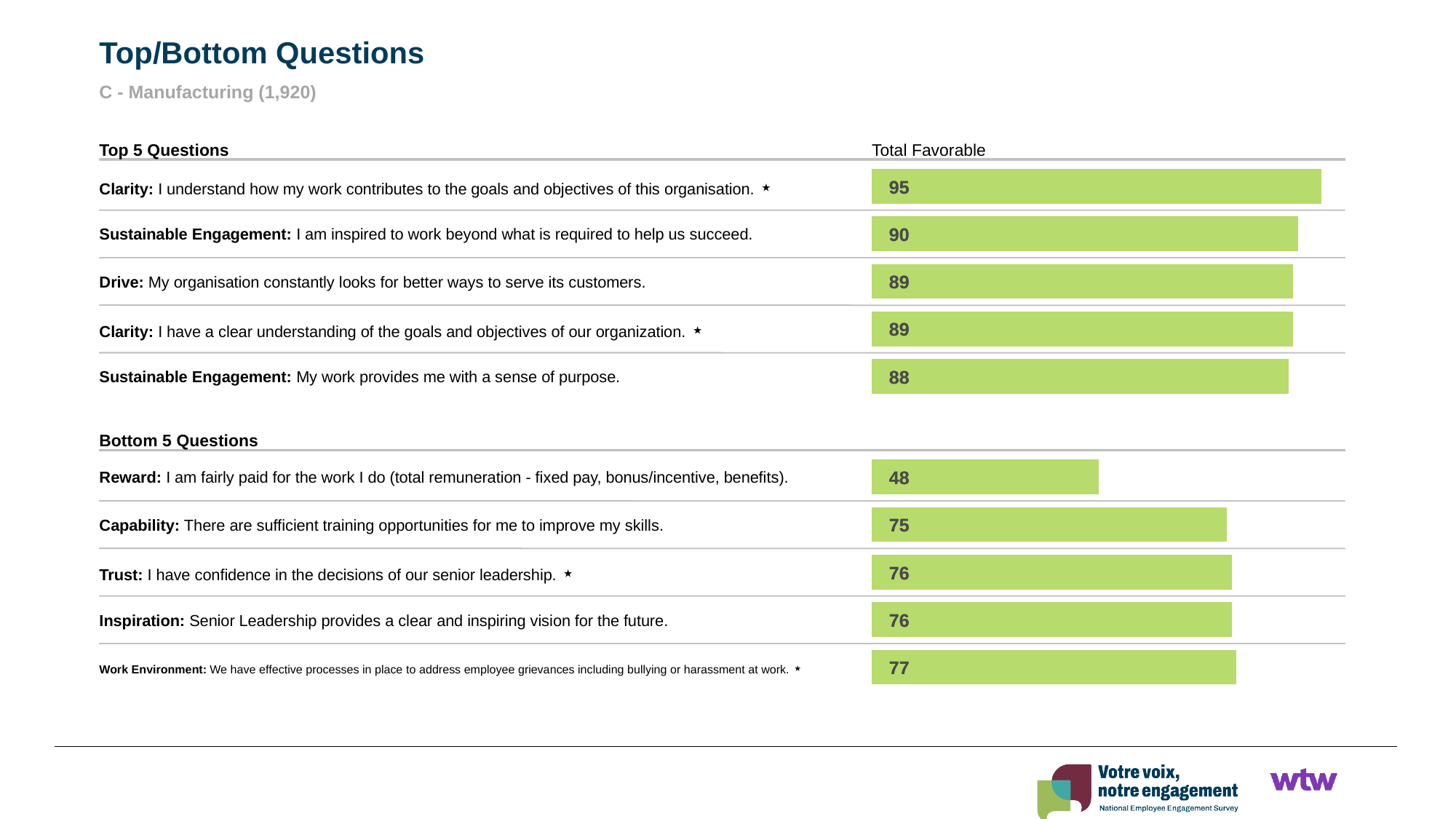
In the Bottom 5 Questions chart, which has a higher Total Favorable value: the Capability question or the Trust question? Trust In the Bottom 5 Questions chart, what is the Total Favorable value for "Reward: I am fairly paid for the work I do"? 48 In the Bottom 5 Questions chart, which question has the highest Total Favorable value? Work Environment: We have effective processes in place to address employee grievances including bullying or harassment at work. What type of chart is used to show the Total Favorable values on this slide? Bar chart In the Bottom 5 Questions chart, what is the difference between the Total Favorable values for the Work Environment question and the Reward question? 29 In the Bottom 5 Questions chart, which question has the lowest Total Favorable value? Reward: I am fairly paid for the work I do (total remuneration - fixed pay, bonus/incentive, benefits). In the Top 5 Questions chart, what is the Total Favorable value for "Sustainable Engagement: My work provides me with a sense of purpose"? 88 In the Top 5 Questions chart, what is the Total Favorable value for "Clarity: I understand how my work contributes to the goals and objectives of this organisation"? 95 In the Top 5 Questions chart, what is the difference between the Total Favorable values for "Clarity: I understand how my work contributes..." (95) and "Sustainable Engagement: I am inspired to work beyond what is required..." (90)? 5 How many questions are shown in the Top 5 Questions chart? 5 In the Top 5 Questions chart, which question has the highest Total Favorable value? Clarity: I understand how my work contributes to the goals and objectives of this organisation. In the Bottom 5 Questions chart, what is the Total Favorable value for "Capability: There are sufficient training opportunities for me to improve my skills"? 75